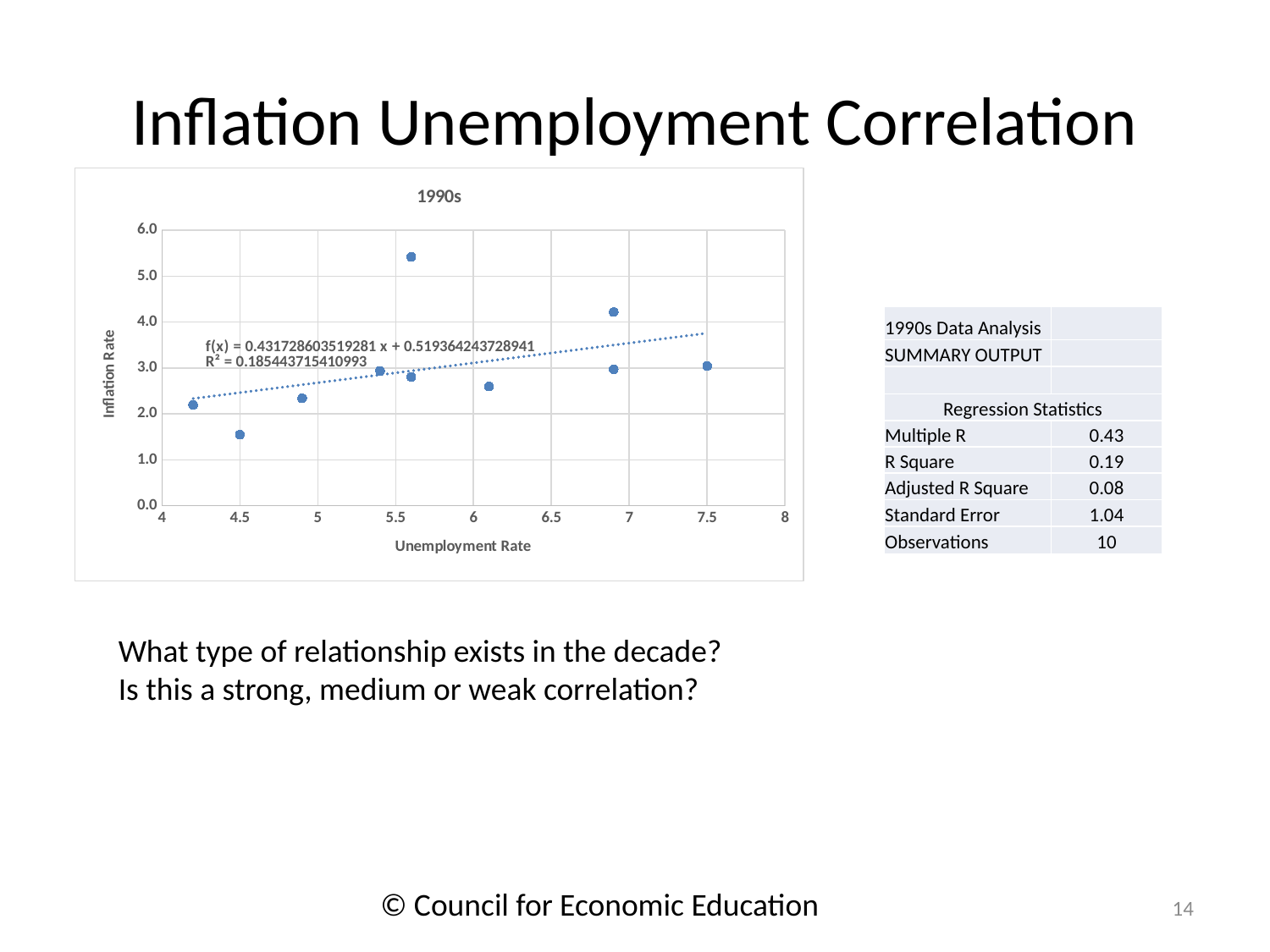
What is the title of the chart? 1990s What kind of chart is shown on the slide? scatter chart Is the highest inflation rate plotted in the 1990s chart greater or less than 5.0? greater Is the lowest inflation rate plotted in the 1990s chart greater or less than 2.0? less How many data points are plotted in the 1990s chart? 10 What R² value is printed on the chart for the trendline? 0.185443715410993 Is the unemployment rate of the leftmost point in the 1990s chart greater or less than 4.5? less Does the dotted trendline in the 1990s chart rise or fall as the unemployment rate increases? rise